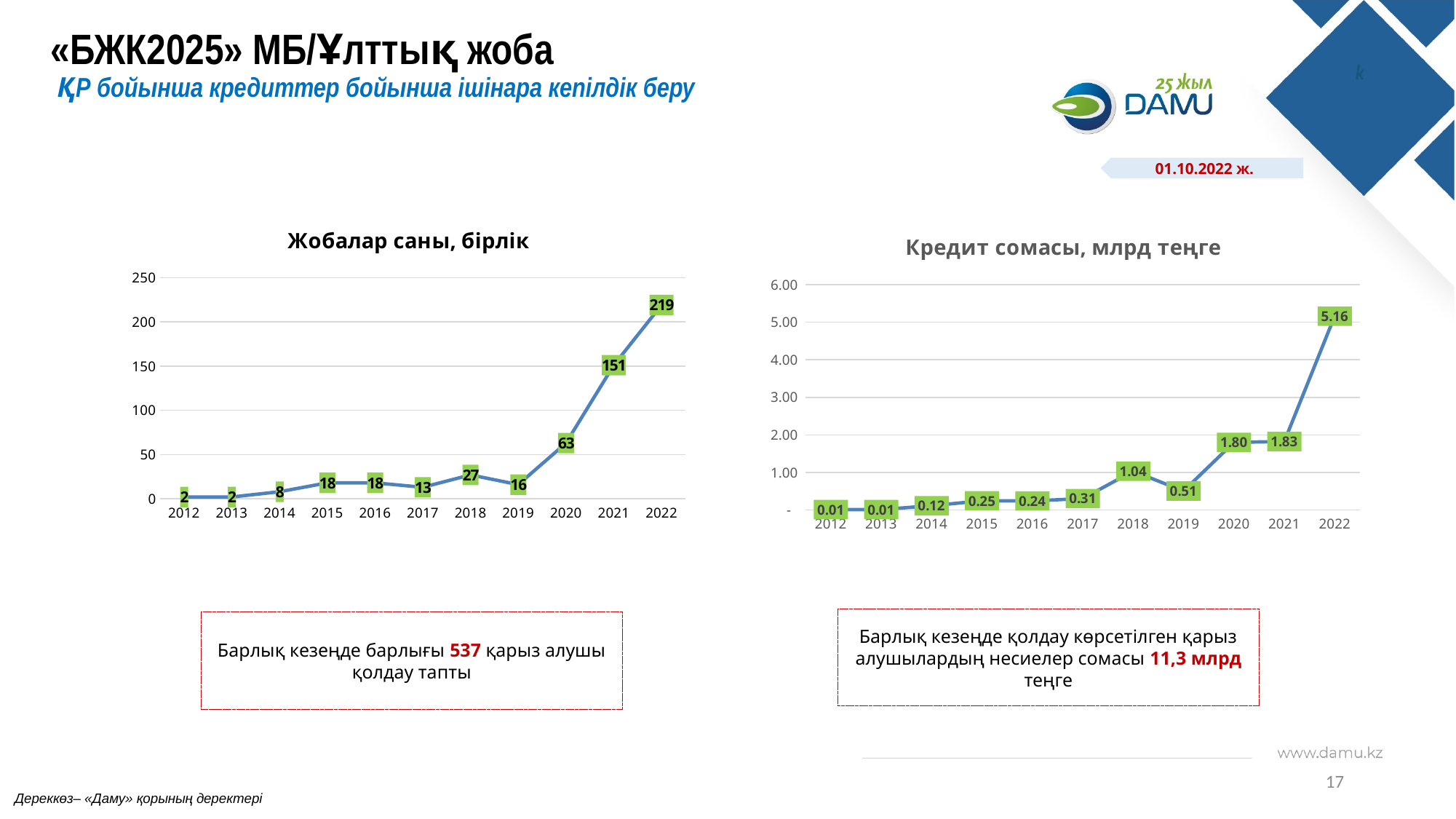
In the chart titled "Кредит сомасы, млрд теңге", what is the value for 2022? 5.16 What kind of chart is the chart titled "Жобалар саны, бірлік"? line chart In the chart titled "Кредит сомасы, млрд теңге", what is the value for 2018? 1.04 In the chart titled "Кредит сомасы, млрд теңге", which year has the lowest value? 2012 and 2013 In the chart titled "Жобалар саны, бірлік", what is the value for 2021? 151 In the chart titled "Кредит сомасы, млрд теңге", do the values generally rise or fall from 2012 to 2022? rise In the chart titled "Жобалар саны, бірлік", what is the difference between the values for 2022 and 2021? 68 In the chart titled "Кредит сомасы, млрд теңге", what is the difference between the values for 2022 and 2021? 3.33 In the chart titled "Жобалар саны, бірлік", which is larger, the value for 2018 or the value for 2019? 2018 In the chart titled "Кредит сомасы, млрд теңге", is the value for 2022 greater or less than 5.00? greater In the chart titled "Жобалар саны, бірлік", how many years are plotted on the x axis? 11 In the chart titled "Жобалар саны, бірлік", which year has the highest value? 2022